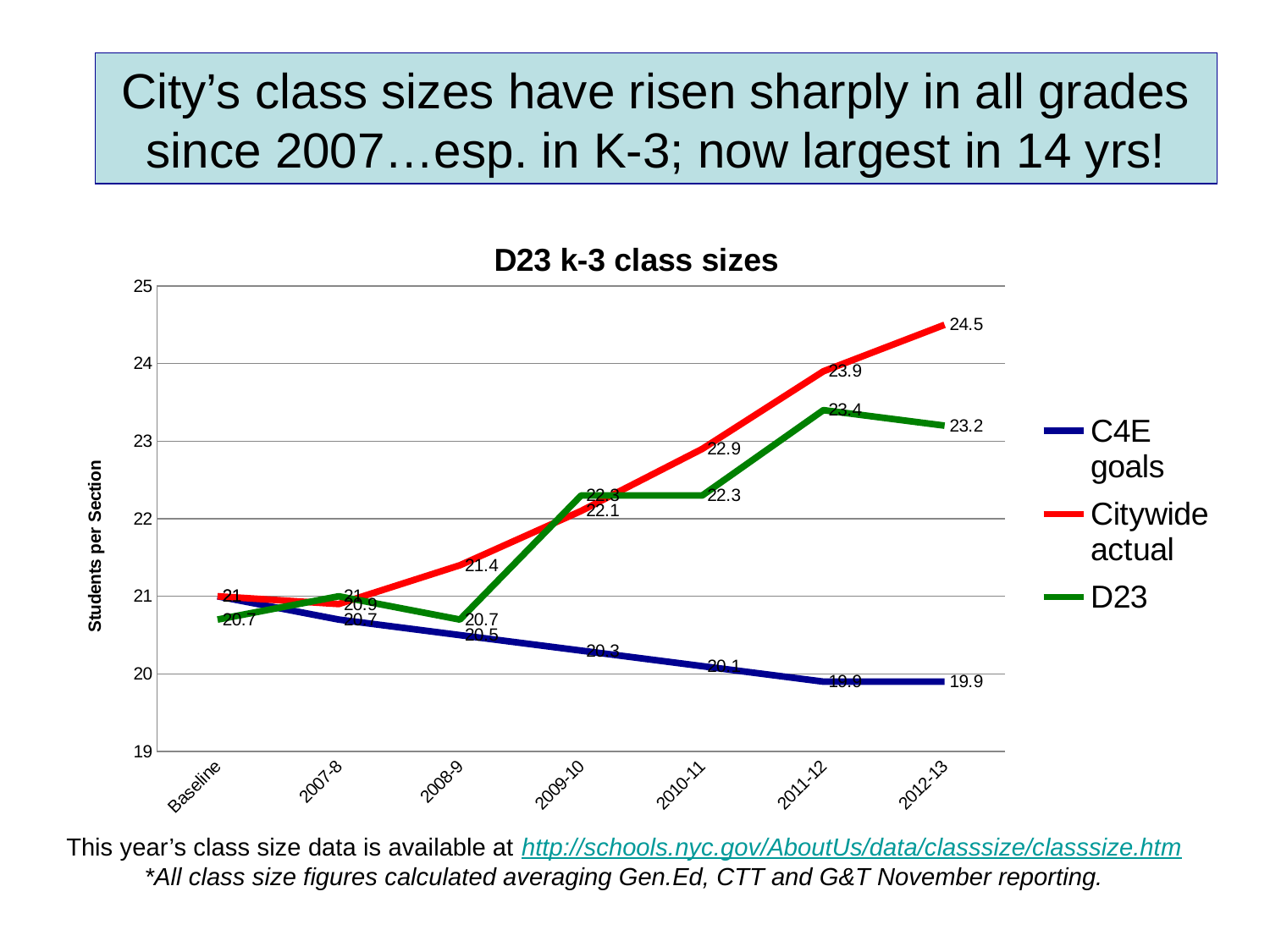
How many series does the legend list? 3 What is the C4E goals value for 2012-13? 19.9 What is the title of the chart? D23 k-3 class sizes Which series has the highest value in 2012-13? Citywide actual Which series has the lowest value in 2012-13? C4E goals What type of chart is shown on the slide? line chart What is the Citywide actual value for 2012-13? 24.5 What is the difference between the Citywide actual and D23 values in 2012-13? 1.3 How many points are plotted along the x axis for each series? 7 What is the D23 value for 2011-12? 23.4 What is the Citywide actual value for 2010-11? 22.9 Does the C4E goals series rise or fall from Baseline to 2012-13? fall